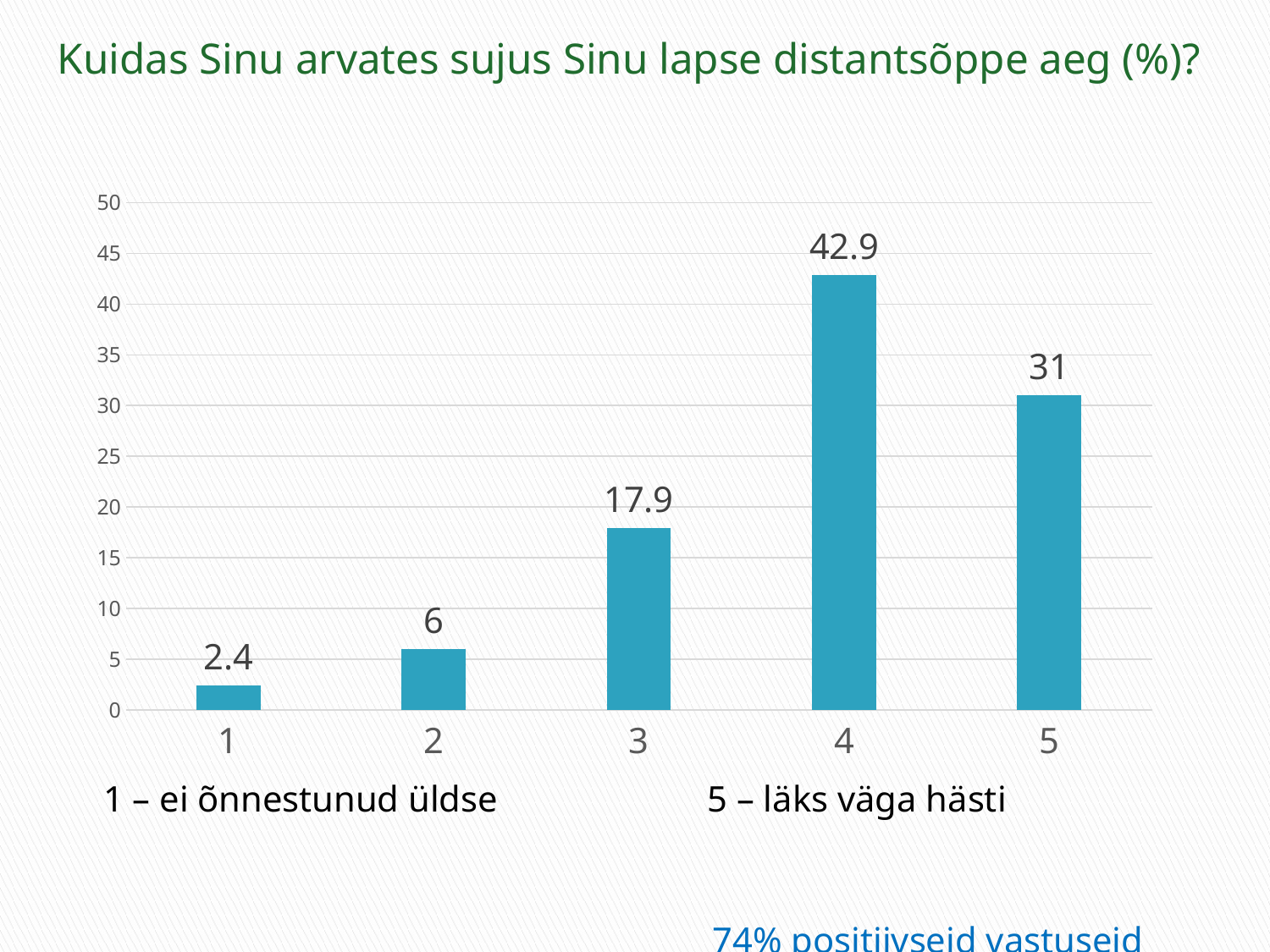
What is the difference between the values for categories 4 and 5? 11.9 What is the value for category 1? 2.4 Which category has the highest value? 4 What is the difference between the values for categories 2 and 1? 3.6 What is the value for category 4? 42.9 How many categories are shown on the x axis? 5 What is the value for category 3? 17.9 Which category has the lowest value? 1 What is the title of the chart? Kuidas Sinu arvates sujus Sinu lapse distantsõppe aeg (%)? What kind of chart is shown on the slide? bar chart Is the value for category 5 greater or less than 25? greater Which is larger, the value for category 3 or the value for category 5? 5